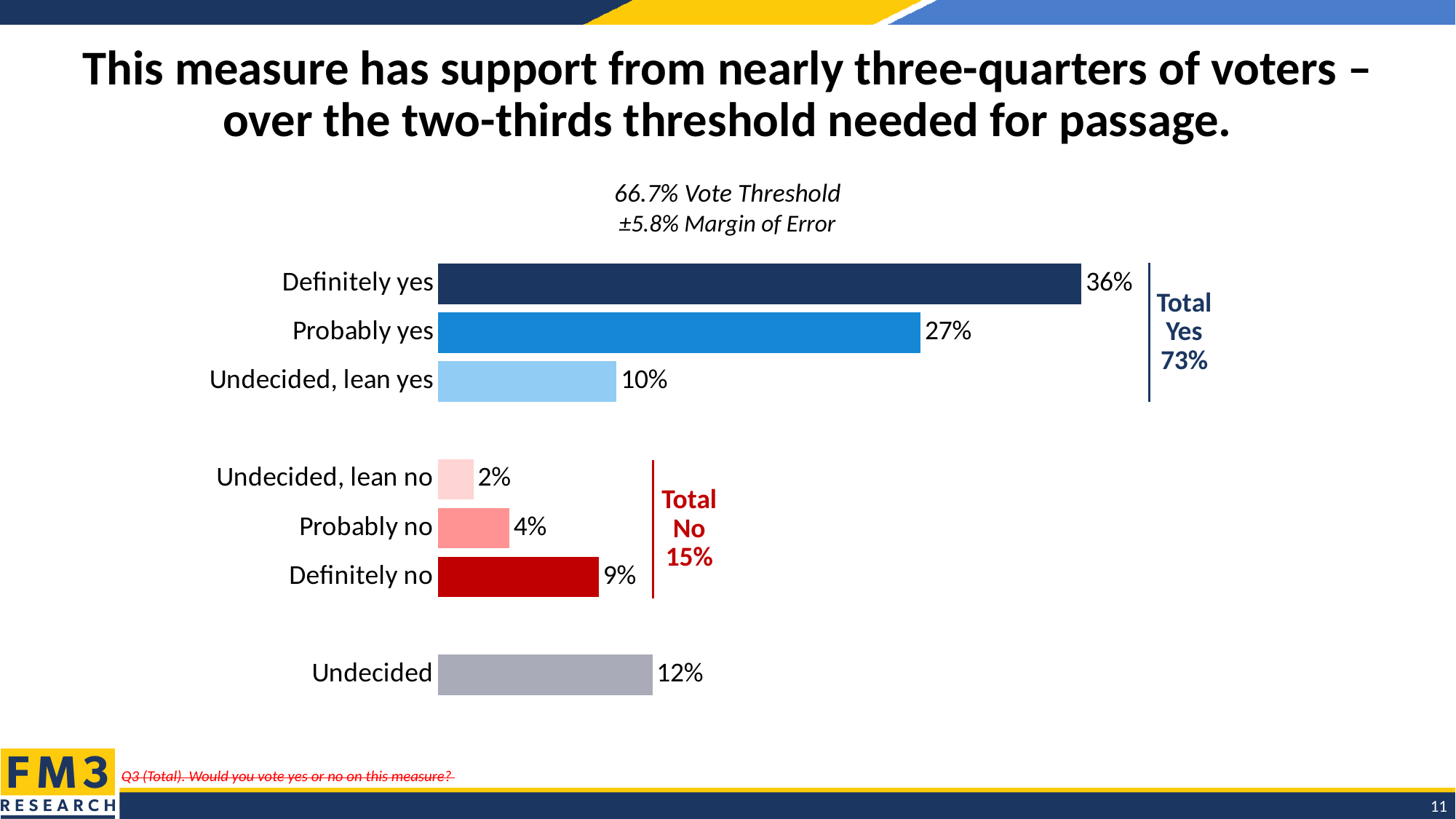
What percentage of voters are "Undecided"? 12% What percentage of voters said "Definitely yes"? 36% What percentage of voters are "Undecided, lean no"? 2% How many response categories are plotted on the chart? 7 What percentage of voters said "Probably yes"? 27% What percentage of voters said "Definitely no"? 9% Which is larger, "Definitely no" or "Probably no"? Definitely no Which response category has the highest percentage? Definitely yes What kind of chart is shown on the slide? Bar chart What is the difference between "Definitely yes" and "Probably yes"? 9 percentage points What is the Total Yes percentage shown on the chart? 73% Which response category has the lowest percentage? Undecided, lean no